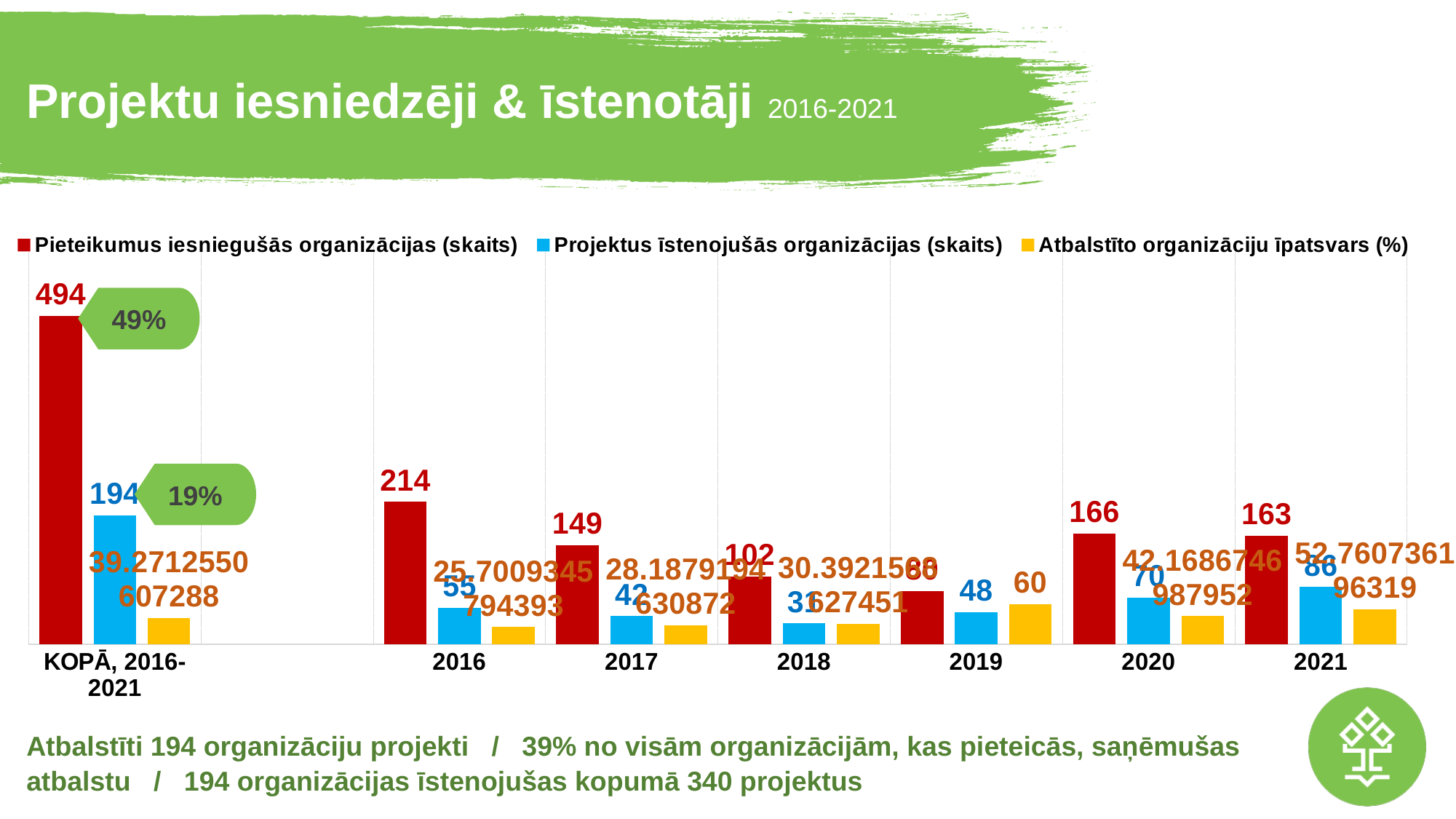
How many categories are shown on the x axis? 7 What is the value of Pieteikumus iesniegušās organizācijas (skaits) for KOPĀ, 2016-2021? 494 What is the difference between the Pieteikumus iesniegušās organizācijas (skaits) values for 2020 and 2021? 3 What is the value of Atbalstīto organizāciju īpatsvars (%) for 2019? 60 Among the individual years 2016 to 2021, which year has the highest value for Pieteikumus iesniegušās organizācijas (skaits)? 2016 What is the value of Projektus īstenojušās organizācijas (skaits) for 2021? 86 What kind of chart is shown on the slide? Bar chart Which year has the larger value for Projektus īstenojušās organizācijas (skaits), 2020 or 2021? 2021 How many series does the legend list? 3 Among the individual years 2016 to 2021, which year has the lowest value for Projektus īstenojušās organizācijas (skaits)? 2018 What is the value of Projektus īstenojušās organizācijas (skaits) for KOPĀ, 2016-2021? 194 What is the value of Pieteikumus iesniegušās organizācijas (skaits) for 2016? 214